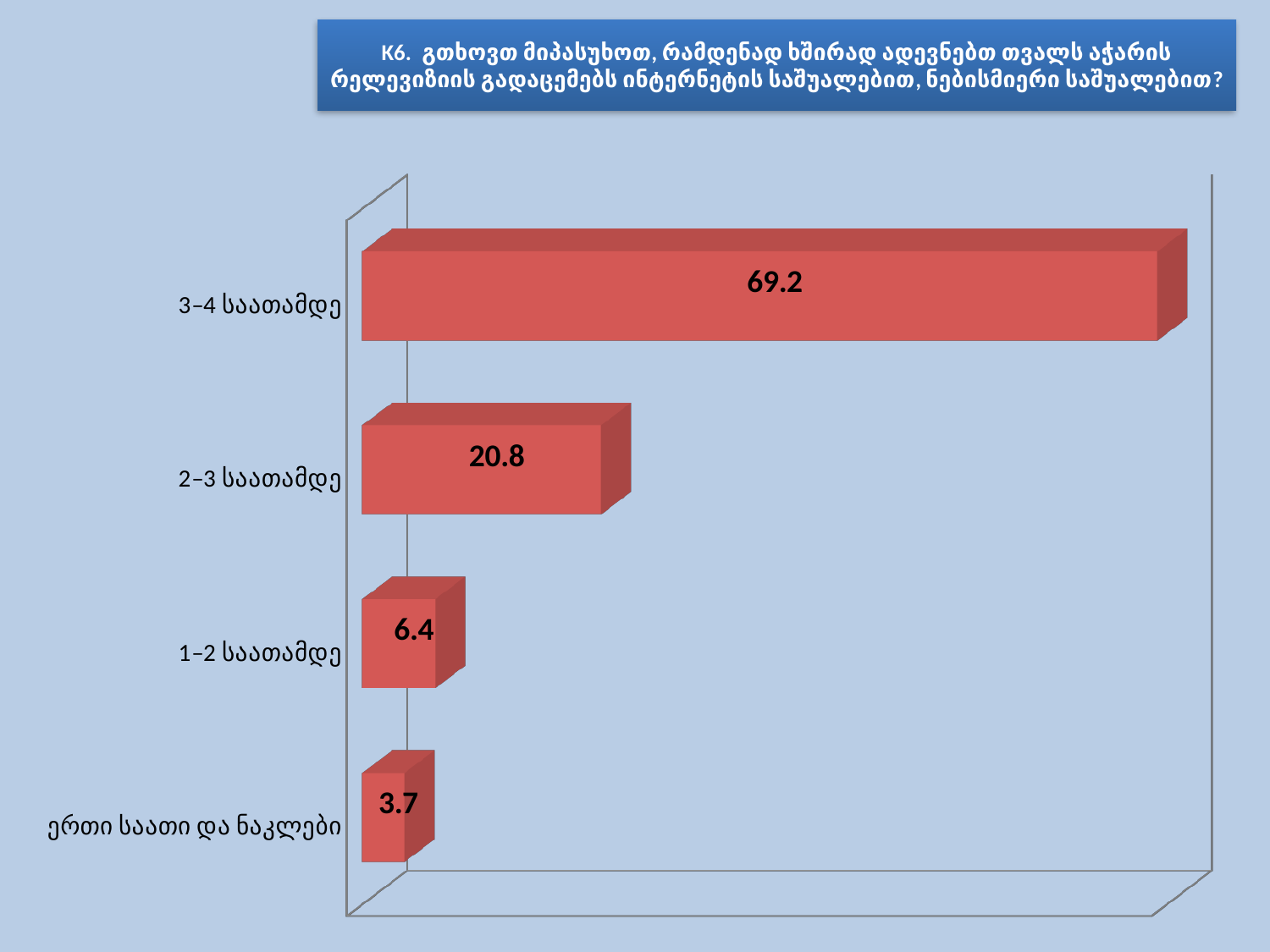
What colour are the bars in the chart? Red Which category has the lowest value? ერთი საათი და ნაკლები What is the value for the category "2-3 საათამდე"? 20.8 Which is larger, the value for "2-3 საათამდე" or the value for "1-2 საათამდე"? 2-3 საათამდე What is the difference between the values for "3-4 საათამდე" and "2-3 საათამდე"? 48.4 Which category has the highest value? 3-4 საათამდე What kind of chart is shown on the slide? Bar chart How many categories are shown in the chart? 4 What is the value for the category "3-4 საათამდე"? 69.2 What is the difference between the values for "1-2 საათამდე" and "ერთი საათი და ნაკლები"? 2.7 What is the value for the category "ერთი საათი და ნაკლები"? 3.7 What is the value for the category "1-2 საათამდე"? 6.4